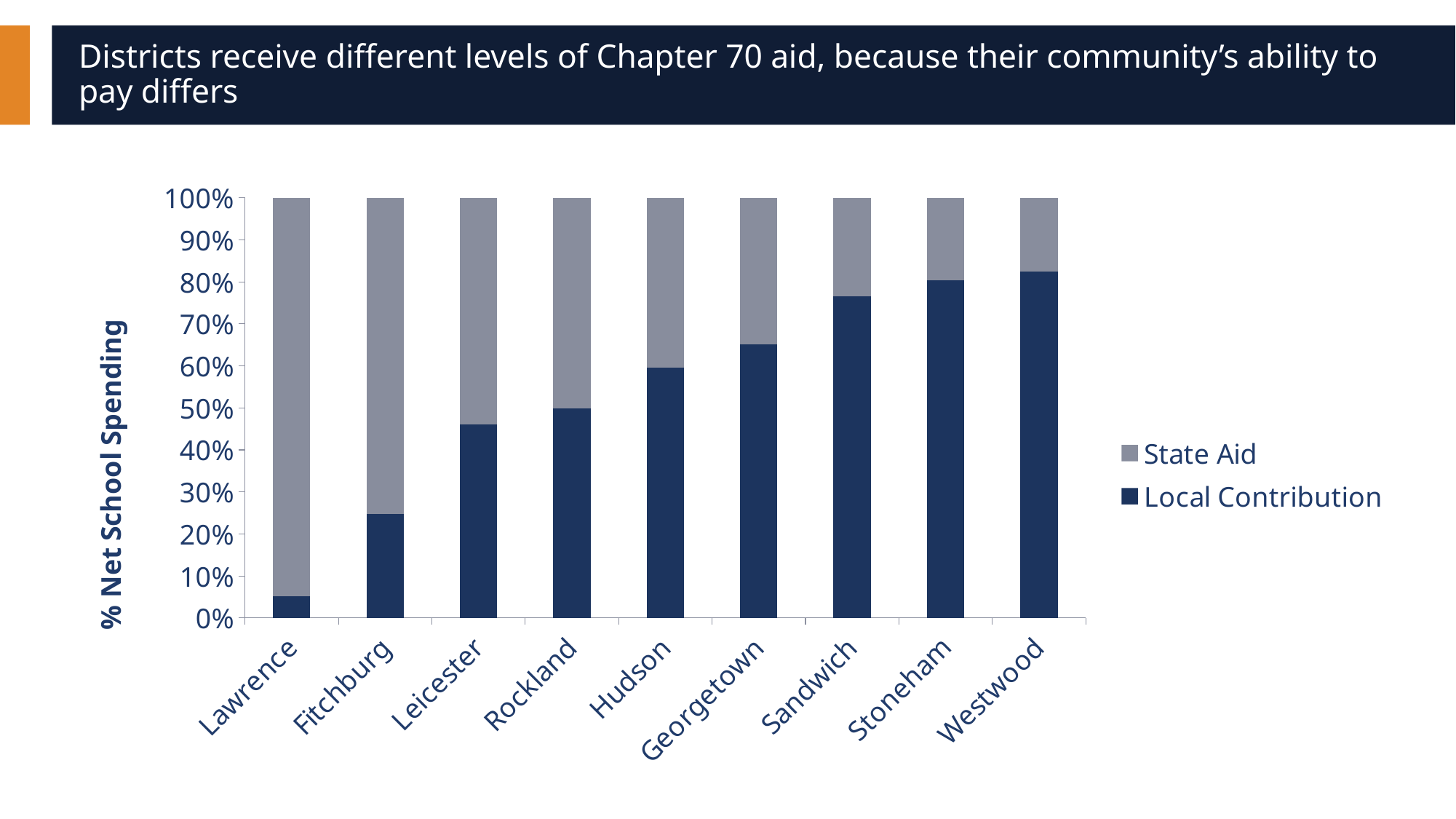
How many districts are shown on the x axis of the chart? 9 Which district has the largest State Aid share? Lawrence Does the Local Contribution share rise or fall moving from Lawrence to Westwood along the x axis? rise What kind of chart is shown on the slide? Stacked bar chart Is the Local Contribution value for Hudson greater or less than 50%? greater Is the Local Contribution value for Sandwich greater or less than 70%? greater Is the Local Contribution value for Fitchburg greater or less than 30%? less How many series does the chart's legend list? 2 Which district has the highest Local Contribution share? Westwood Which district has the lowest Local Contribution share? Lawrence What is the label on the chart's vertical axis? % Net School Spending Which is larger, the Local Contribution share for Leicester or for Georgetown? Georgetown